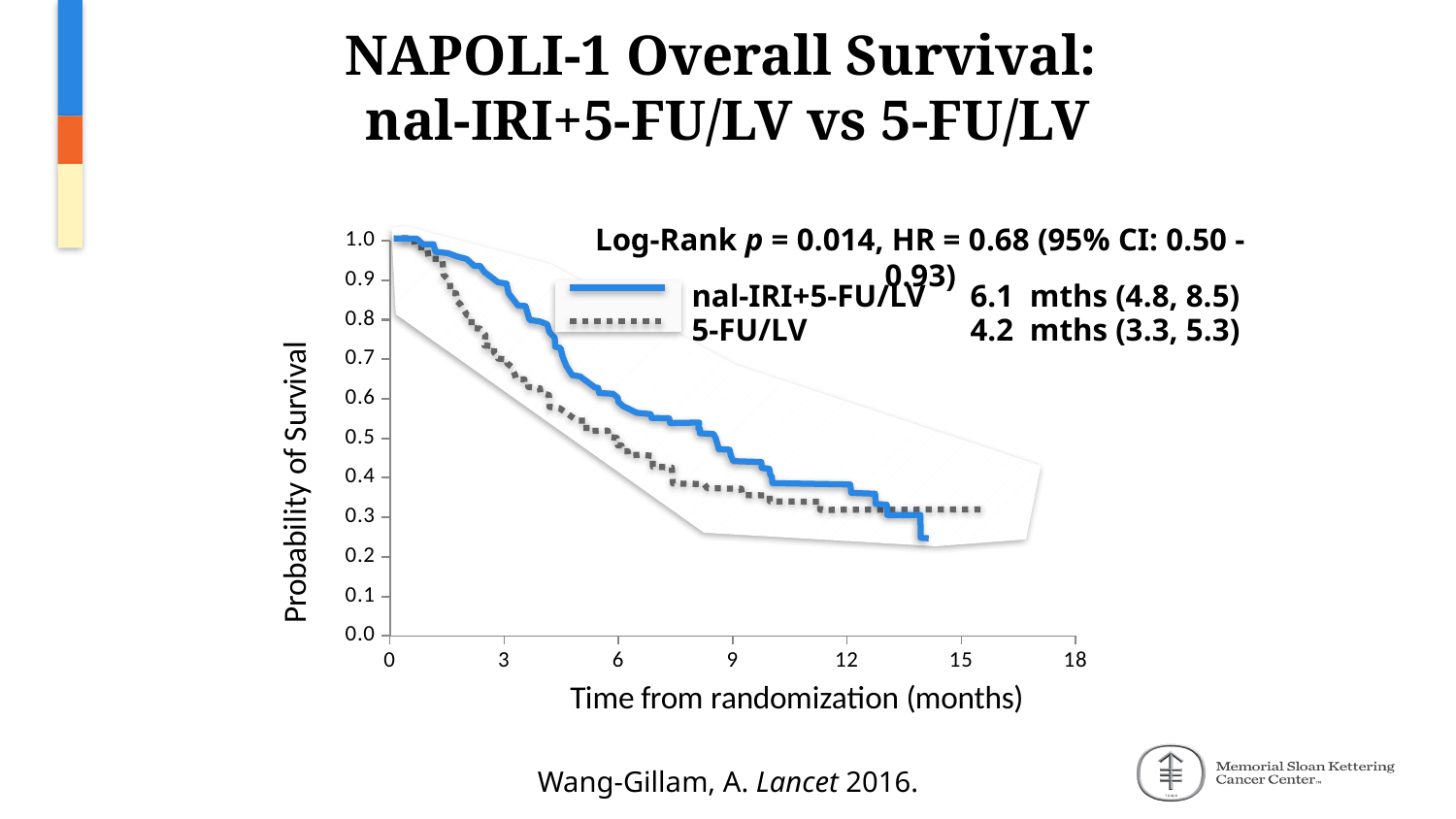
What hazard ratio is reported on the chart? 0.68 What is the label of the x axis? Time from randomization (months) What is the difference in median survival between the nal-IRI+5-FU/LV and 5-FU/LV arms? 1.9 mths At 12 months, is the probability of survival for the nal-IRI+5-FU/LV curve greater or less than 0.5? less Which arm has the higher median overall survival? nal-IRI+5-FU/LV Do the survival curves rise or fall as time from randomization increases? Fall What is the median overall survival shown for the 5-FU/LV arm? 4.2 mths What kind of chart is shown on the slide? Line chart (Kaplan-Meier survival curve) What is the median overall survival shown for the nal-IRI+5-FU/LV arm? 6.1 mths How many series does the legend list? 2 At 6 months, is the probability of survival for the nal-IRI+5-FU/LV curve greater or less than 0.5? greater What is the 95% confidence interval printed for the 5-FU/LV median survival? (3.3, 5.3)